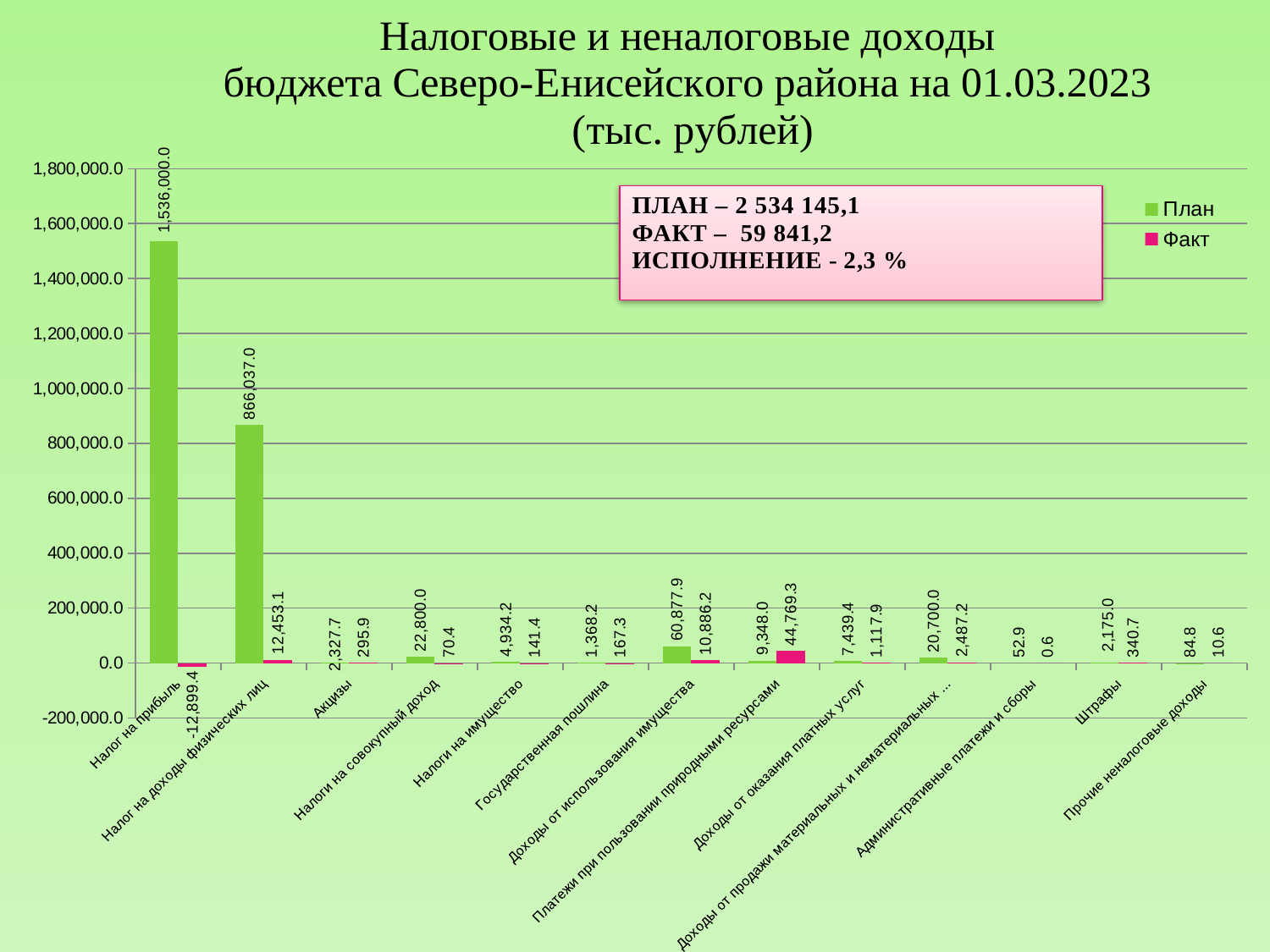
What is the difference between the План and Факт values for Налог на доходы физических лиц? 853,583.9 How many series does the legend list? 2 Which category has the highest План value? Налог на прибыль What is the Факт value for Административные платежи и сборы? 0.6 Which category has the highest Факт value? Платежи при пользовании природными ресурсами What is the Факт value for Платежи при пользовании природными ресурсами? 44,769.3 Is the План value for Налог на доходы физических лиц greater or less than 800,000.0? greater How many categories are shown on the x axis? 13 Which category has the lowest Факт value? Налог на прибыль What is the План value for Налог на прибыль? 1,536,000.0 What kind of chart is shown on the slide? bar chart Which is larger: the План value for Акцизы or the План value for Штрафы? Акцизы